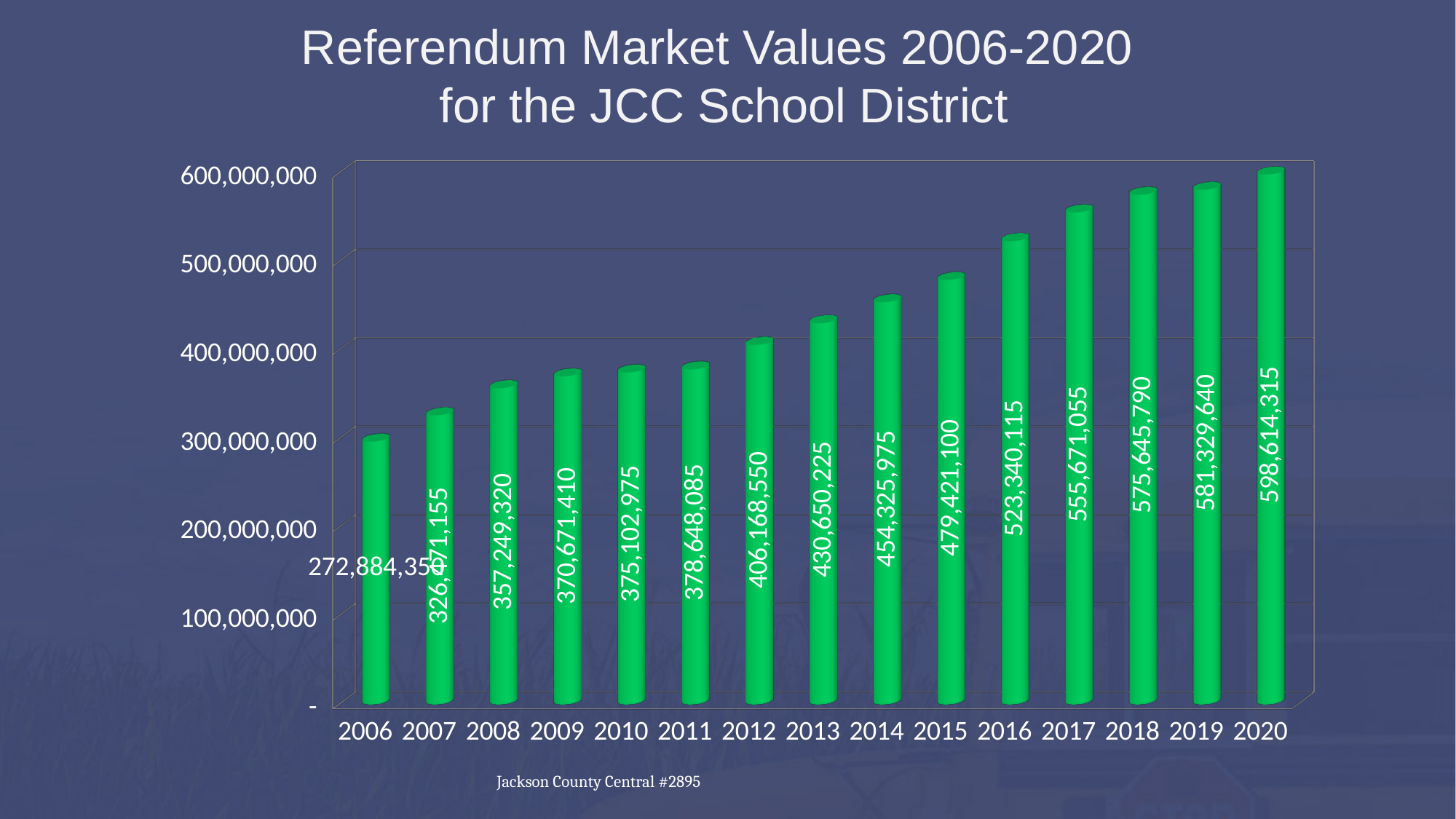
What is the difference between the 2020 and 2019 referendum market values? 17,284,675 What is the referendum market value for 2020? 598,614,315 What kind of chart is shown on the slide? bar chart What is the difference between the 2016 and 2015 referendum market values? 43,919,015 Which year has the lowest referendum market value? 2006 Which year has the highest referendum market value? 2020 Which year has a larger referendum market value, 2012 or 2011? 2012 How many years are shown on the chart? 15 What is the referendum market value for 2013? 430,650,225 What is the referendum market value for 2009? 370,671,410 Do the referendum market values rise or fall from 2006 to 2020? rise